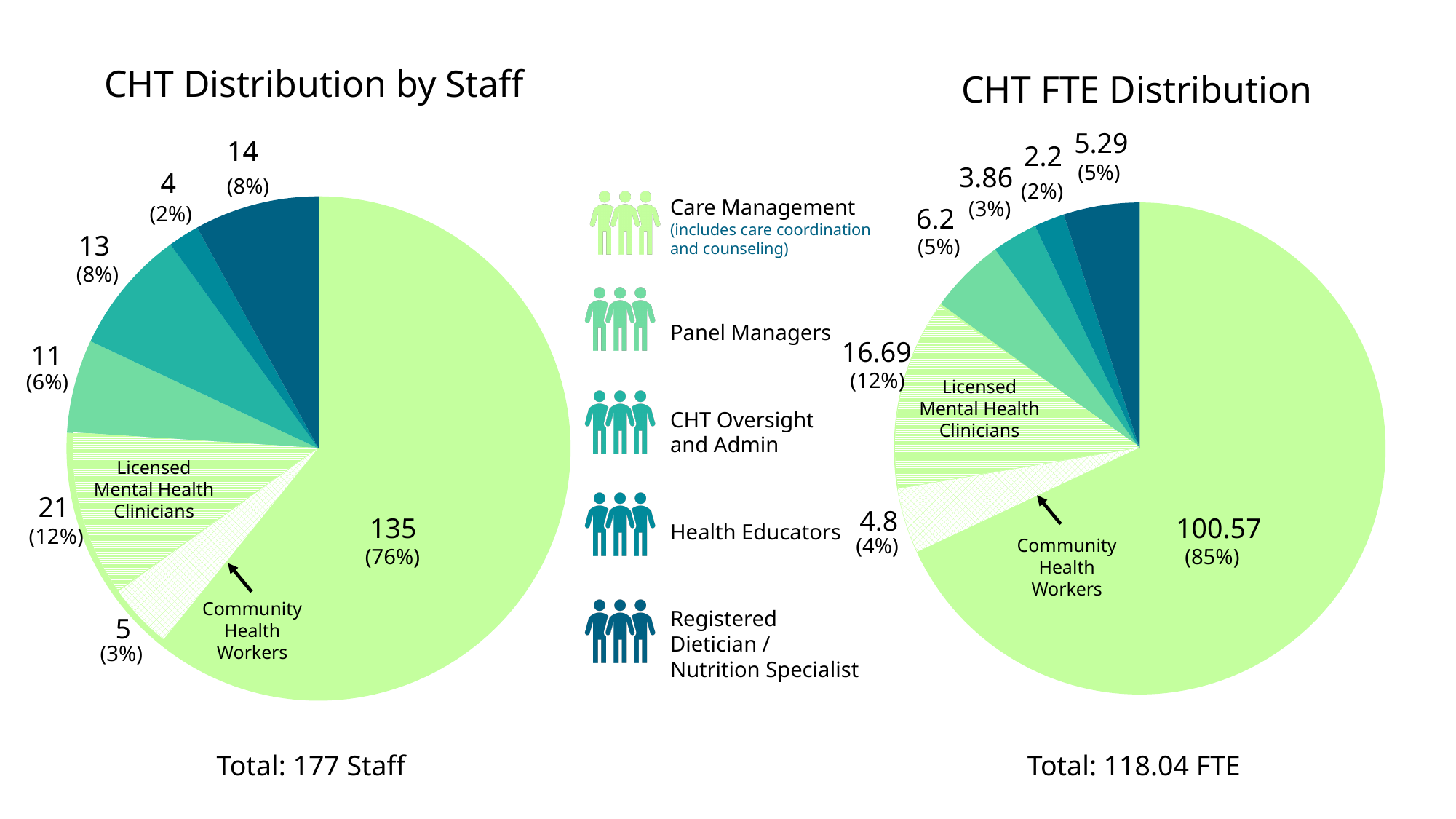
In the CHT Distribution by Staff chart, what value is shown for Licensed Mental Health Clinicians? 21 (12%) In the CHT Distribution by Staff chart, what is the value of the largest slice? 135 In the CHT Distribution by Staff chart, which is larger: Licensed Mental Health Clinicians or Community Health Workers? Licensed Mental Health Clinicians In the CHT FTE Distribution chart, what value is shown for Licensed Mental Health Clinicians? 16.69 (12%) In the CHT FTE Distribution chart, what share of the pie does the largest slice represent? 85% What total is stated below the CHT FTE Distribution chart? 118.04 FTE In the CHT Distribution by Staff chart, what value is shown for Community Health Workers? 5 (3%) In the CHT Distribution by Staff chart, what is the difference between the Licensed Mental Health Clinicians slice and the Community Health Workers slice? 16 In the CHT FTE Distribution chart, what is the value of the largest slice? 100.57 In the CHT FTE Distribution chart, what value is shown for Community Health Workers? 4.8 (4%) What kind of chart is CHT FTE Distribution? Pie chart How many slices does the CHT Distribution by Staff pie chart have? 7